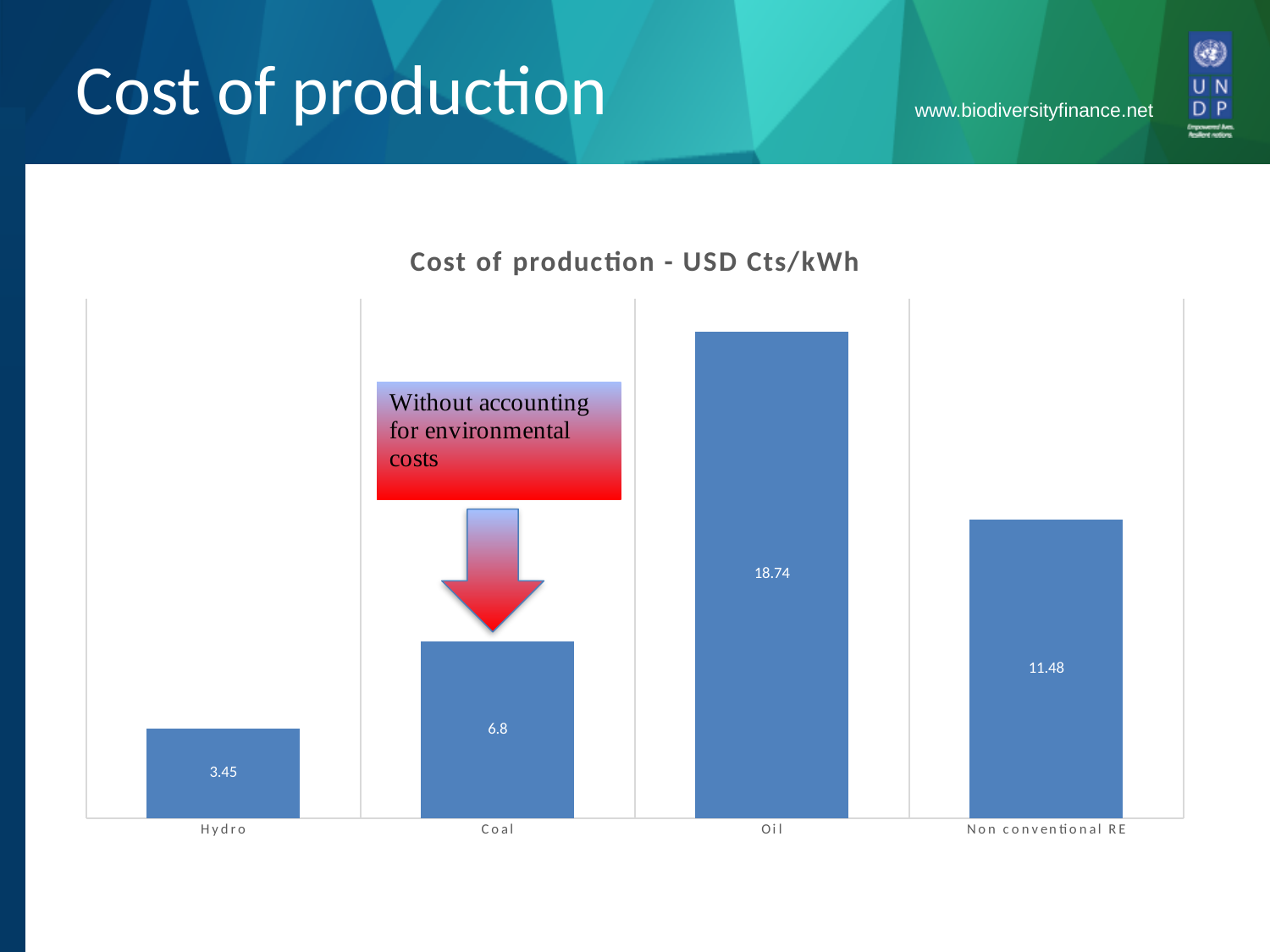
How many categories are shown in the chart? 4 Which category has the highest cost of production? Oil Which category has the lowest cost of production? Hydro What is the cost of production for Hydro? 3.45 What type of chart is shown on the slide? Bar chart What is the cost of production for Coal? 6.8 What is the difference in cost of production between Non conventional RE and Hydro? 8.03 What is the cost of production for Non conventional RE? 11.48 What is the title of the chart? Cost of production - USD Cts/kWh Which has a higher cost of production, Coal or Non conventional RE? Non conventional RE What is the cost of production for Oil? 18.74 What is the difference in cost of production between Oil and Coal? 11.94